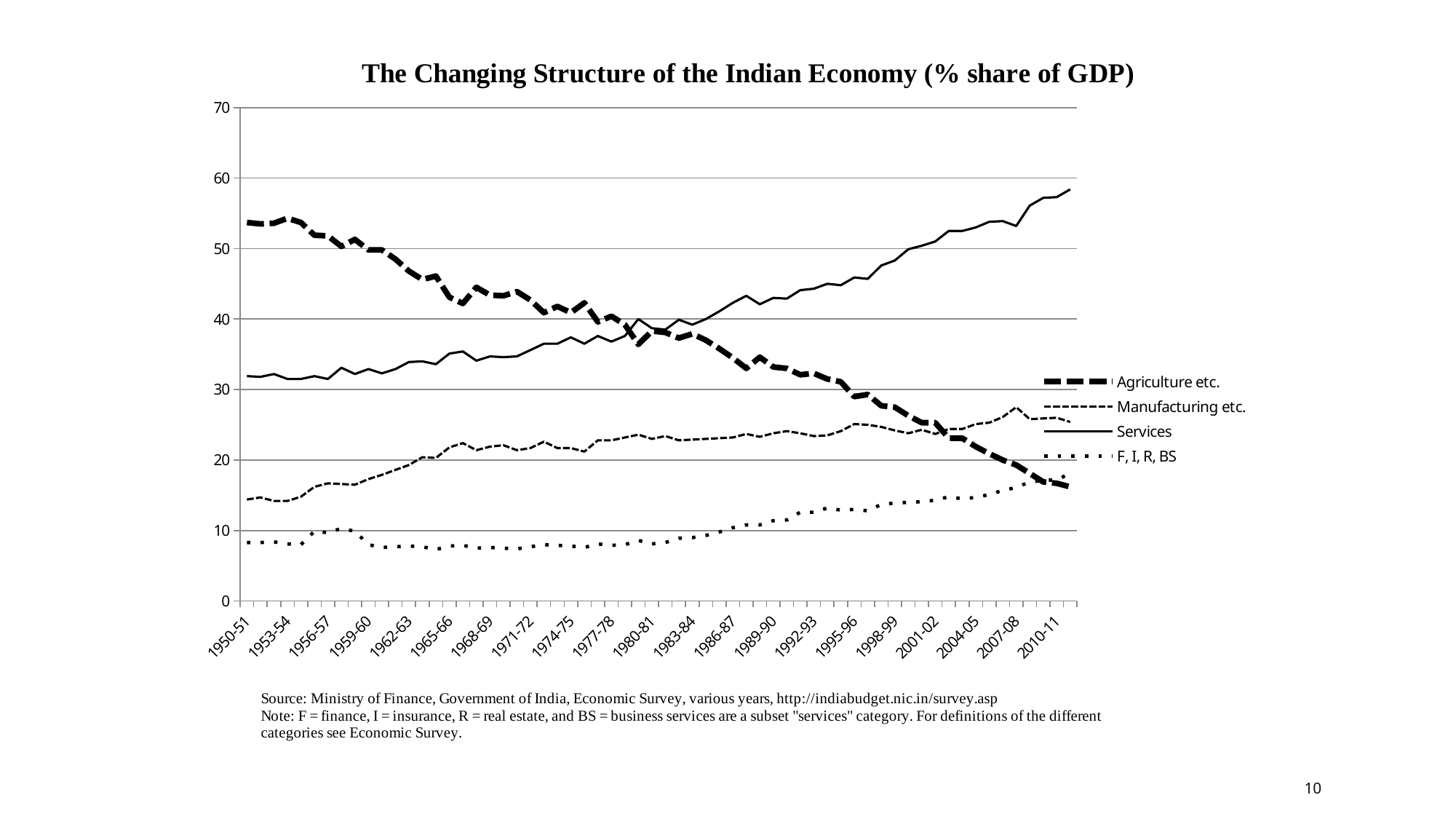
What is the title of the chart? The Changing Structure of the Indian Economy (% share of GDP) Which series has the highest value in 2010-11? Services Is the value for Manufacturing etc. in 1950-51 greater or less than 20? less In 1950-51, which is larger: Agriculture etc. or Services? Agriculture etc. Which series is drawn with a dotted line in the legend? F, I, R, BS Does the Agriculture etc. series rise or fall from 1950-51 to 2010-11? fall Is the value for Services in 2010-11 greater or less than 50? greater How many series does the legend list? 4 Is the value for F, I, R, BS in 1950-51 greater or less than 10? less Does the Services series rise or fall from 1950-51 to 2010-11? rise What kind of chart is shown on the slide? line chart